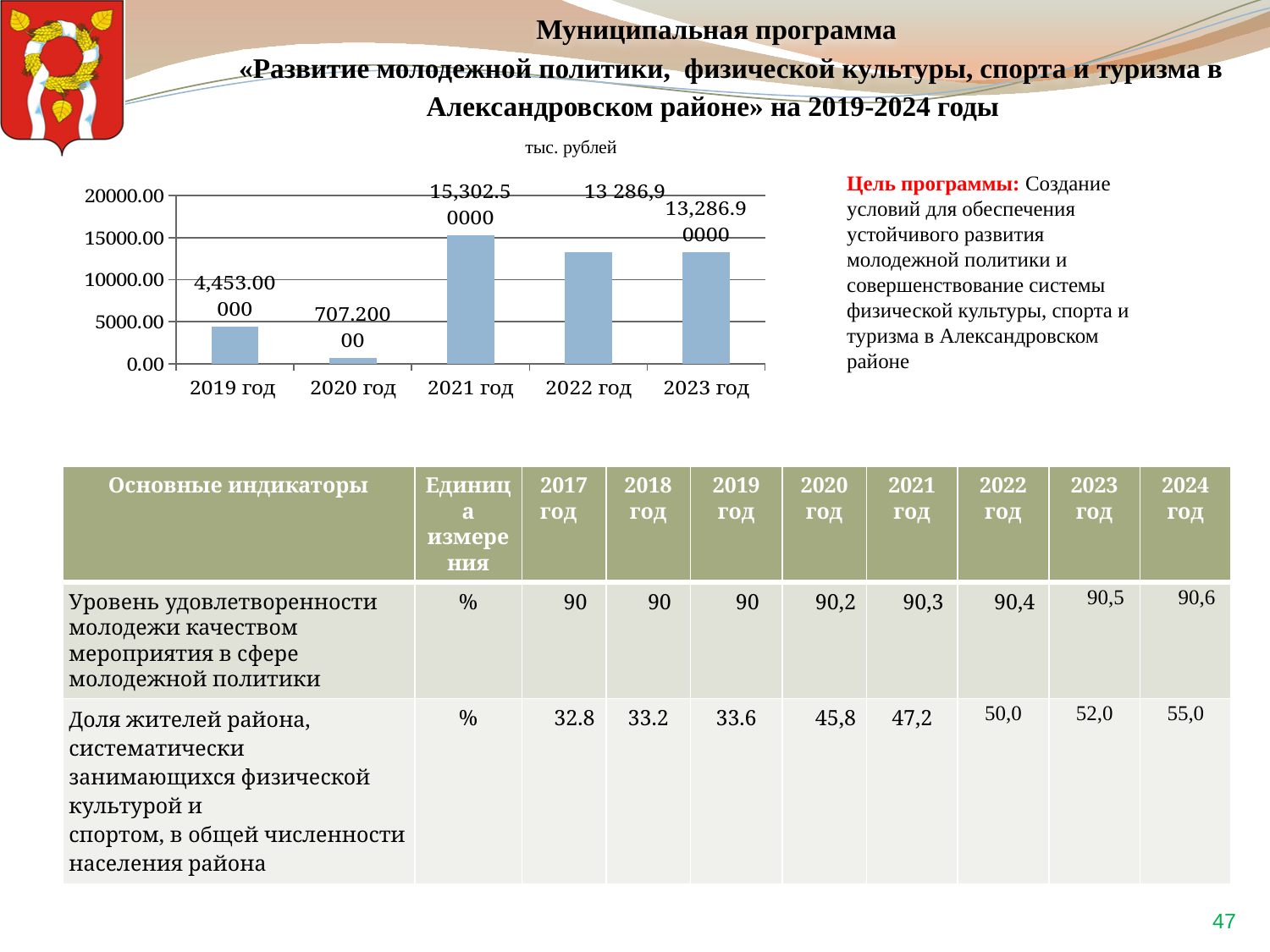
What unit of measurement is stated above the chart? тыс. рублей Which year has the highest value in the chart? 2021 год Which is larger in the chart, the value for 2019 год or the value for 2020 год? 2019 год Is the value for 2022 год greater or less than 10000.00? greater Is the value for 2021 год greater or less than 15000.00? greater What is the data label shown for 2022 год in the chart? 13 286,9 How many years (categories) are shown on the x axis of the chart? 5 Is the value for 2020 год greater or less than 5000.00? less Which is larger in the chart, the value for 2021 год or the value for 2022 год? 2021 год Which year has the lowest value in the chart? 2020 год What is the highest value shown on the chart's y axis? 20000.00 What kind of chart is shown on the slide? bar chart